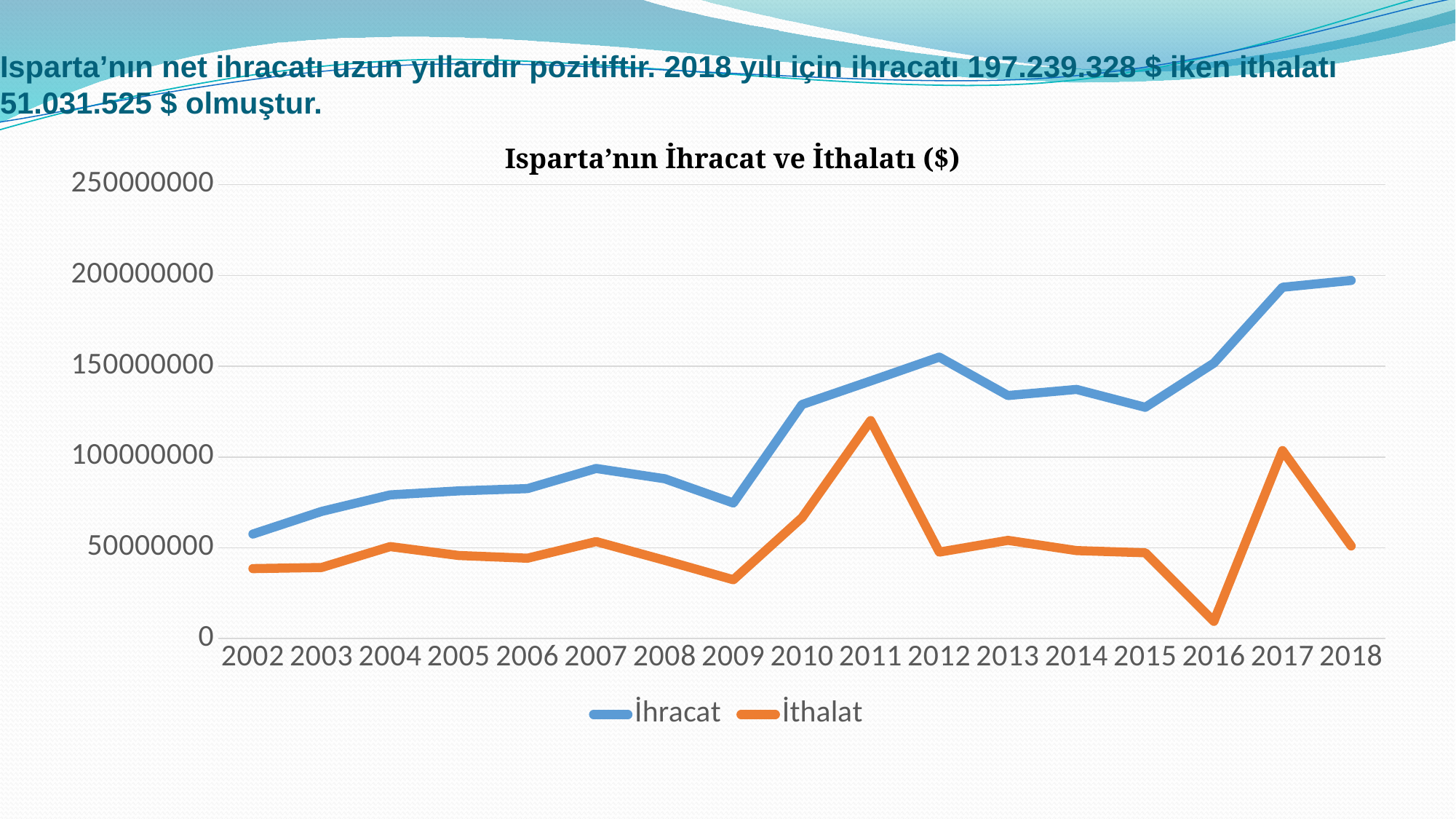
How many years are plotted along the x axis? 17 What kind of chart is shown on the slide? line chart According to the slide, what was Isparta's İthalat (imports) in 2018? 51.031.525 $ What is the title of the chart? Isparta’nın İhracat ve İthalatı ($) How many series does the legend list? 2 In which year is İthalat at its lowest? 2016 Is the value of İthalat in 2011 greater or less than 100000000? greater In which year is İhracat at its highest? 2018 Is the value of İhracat in 2002 greater or less than 100000000? less According to the slide, what was Isparta's İhracat (exports) in 2018? 197.239.328 $ In which year is İthalat at its highest? 2011 What is the difference between İhracat and İthalat in 2018? 146.207.803 $